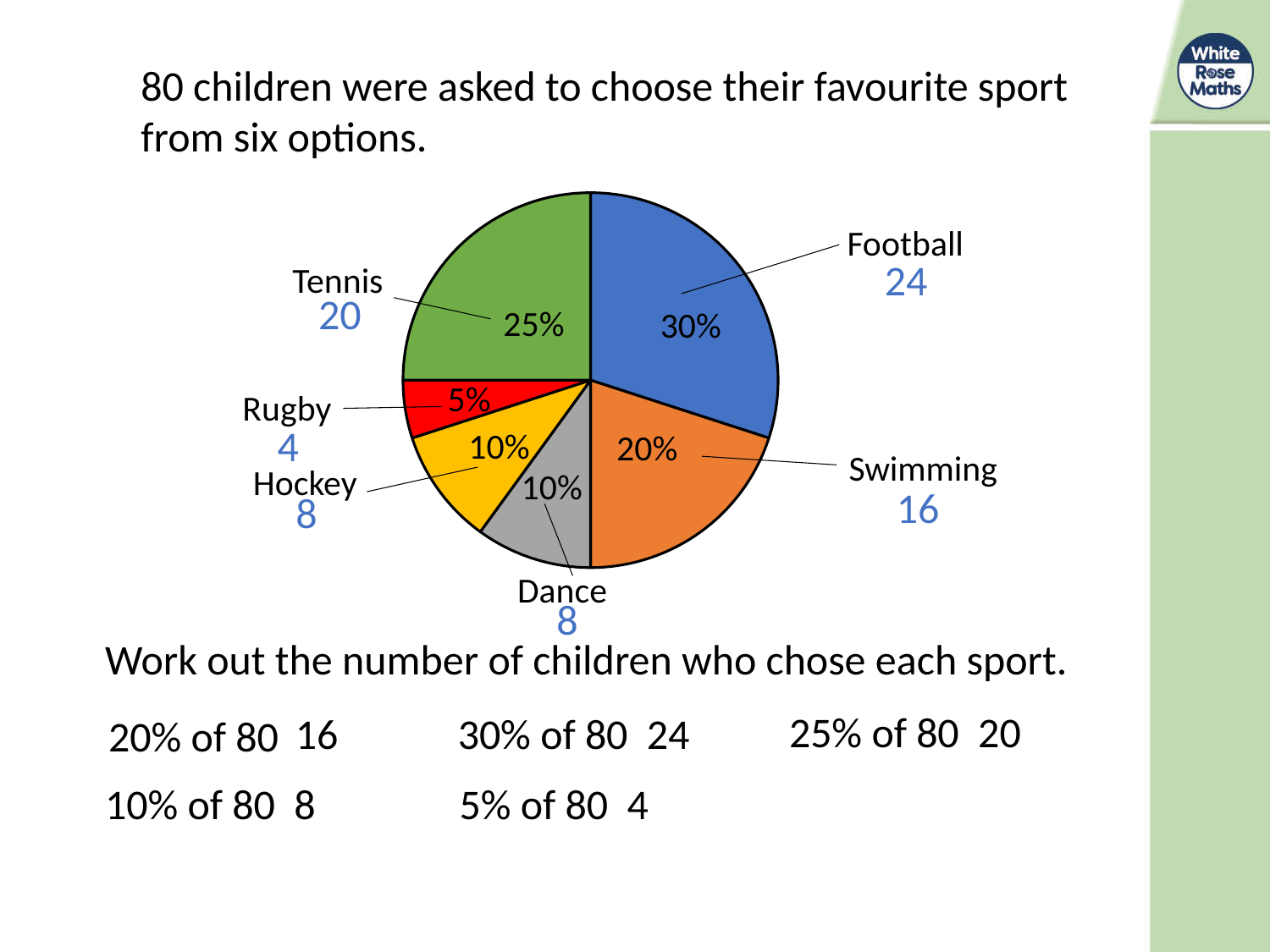
Which sport has the smallest slice of the pie chart? Rugby How many children chose Hockey? 8 What is the difference in percentage between Football and Tennis? 5% What percentage of the pie chart is Swimming? 20% How many children chose Tennis? 20 How many sports are shown in the pie chart? 6 Which sport has the largest slice of the pie chart? Football What type of chart is shown on the slide? Pie chart What percentage of the pie chart is Rugby? 5% Which is larger, the Tennis slice or the Swimming slice? Tennis What percentage of the pie chart is Football? 30% How many more children chose Swimming than Dance? 8